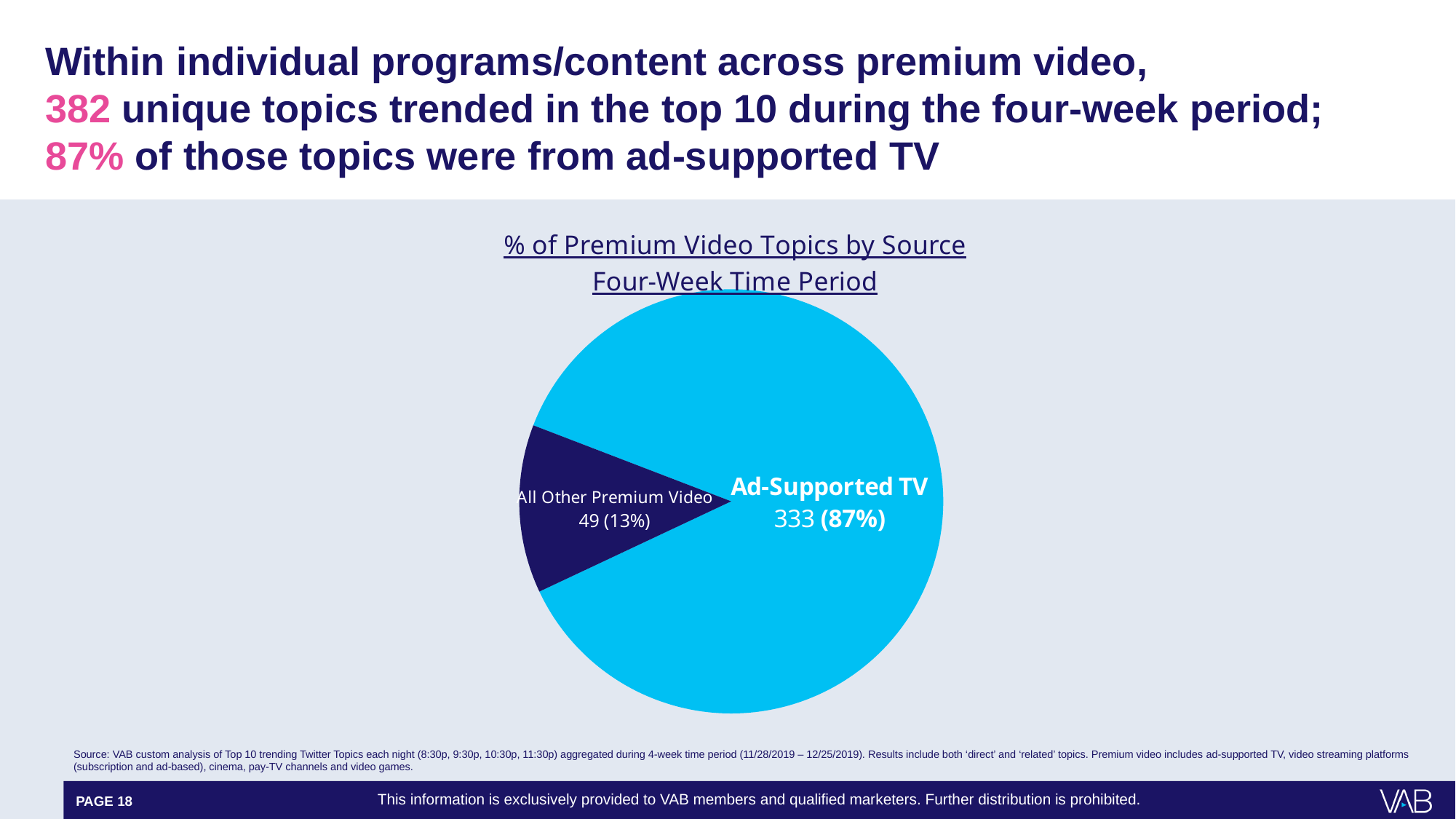
What share of the pie does Ad-Supported TV represent? 87% What share of the pie does All Other Premium Video represent? 13% How many slices does the pie chart have? 2 What is the title of the pie chart? % of Premium Video Topics by Source Four-Week Time Period What is the difference in topic count between Ad-Supported TV and All Other Premium Video? 284 How many topics are attributed to All Other Premium Video in the pie chart? 49 Which slice of the pie chart is the largest? Ad-Supported TV Which slice of the pie chart is the smallest? All Other Premium Video What is the total number of topics represented in the pie chart? 382 What kind of chart is shown on the slide? Pie chart How many topics are attributed to Ad-Supported TV in the pie chart? 333 Which has more topics, Ad-Supported TV or All Other Premium Video? Ad-Supported TV